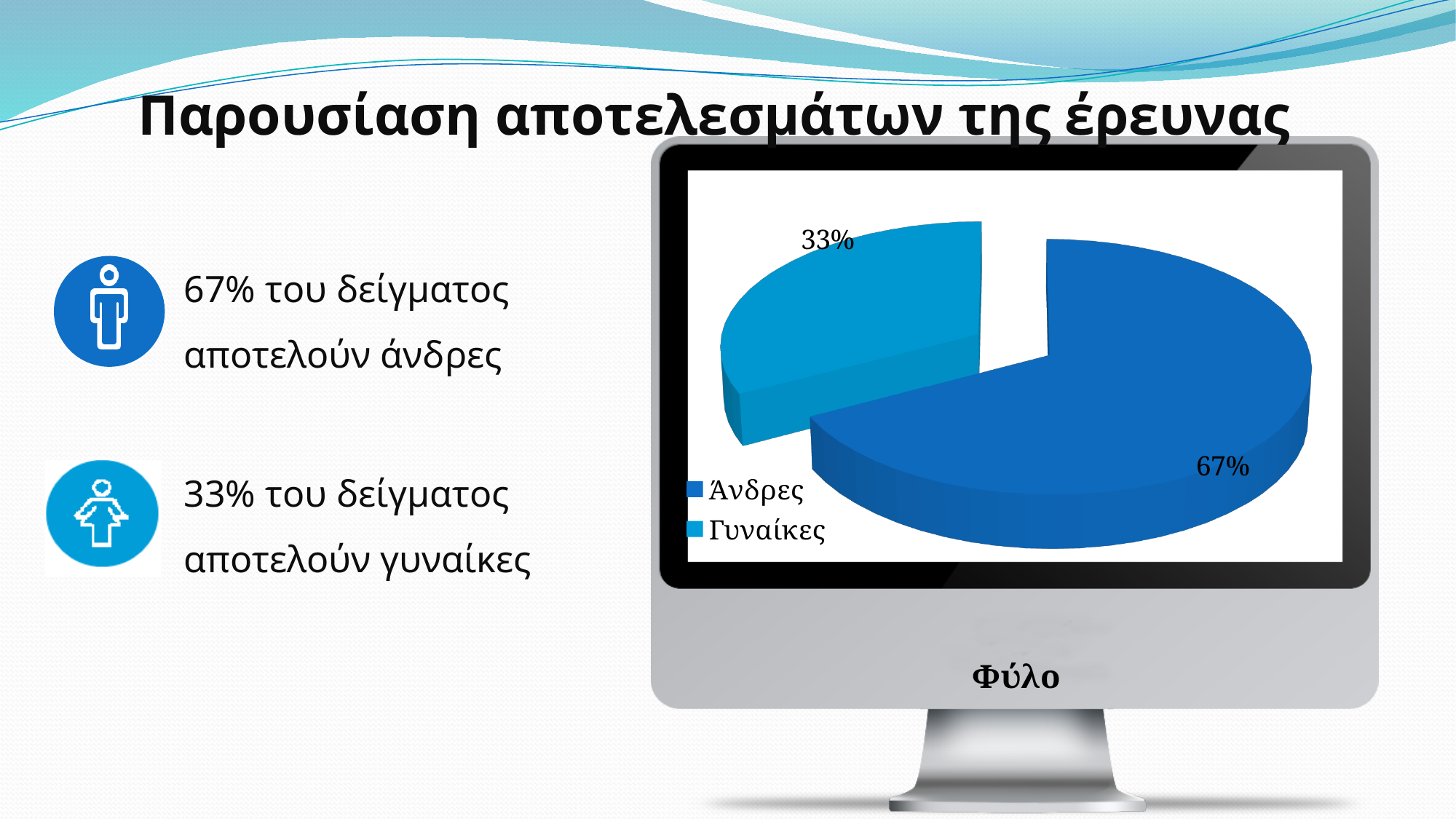
What is the title of the chart? Φύλο What share of the pie chart is labelled Άνδρες? 67% What share of the pie chart is labelled Γυναίκες? 33% Which category has the smallest slice in the pie chart? Γυναίκες Which slice is larger, Άνδρες or Γυναίκες? Άνδρες What is the difference in percentage points between the Άνδρες and Γυναίκες slices? 34 What kind of chart is shown on the slide? pie chart How many entries does the chart legend list? 2 How many slices does the pie chart have? 2 Which category has the largest slice in the pie chart? Άνδρες Which legend entry is shown in the lighter blue colour? Γυναίκες